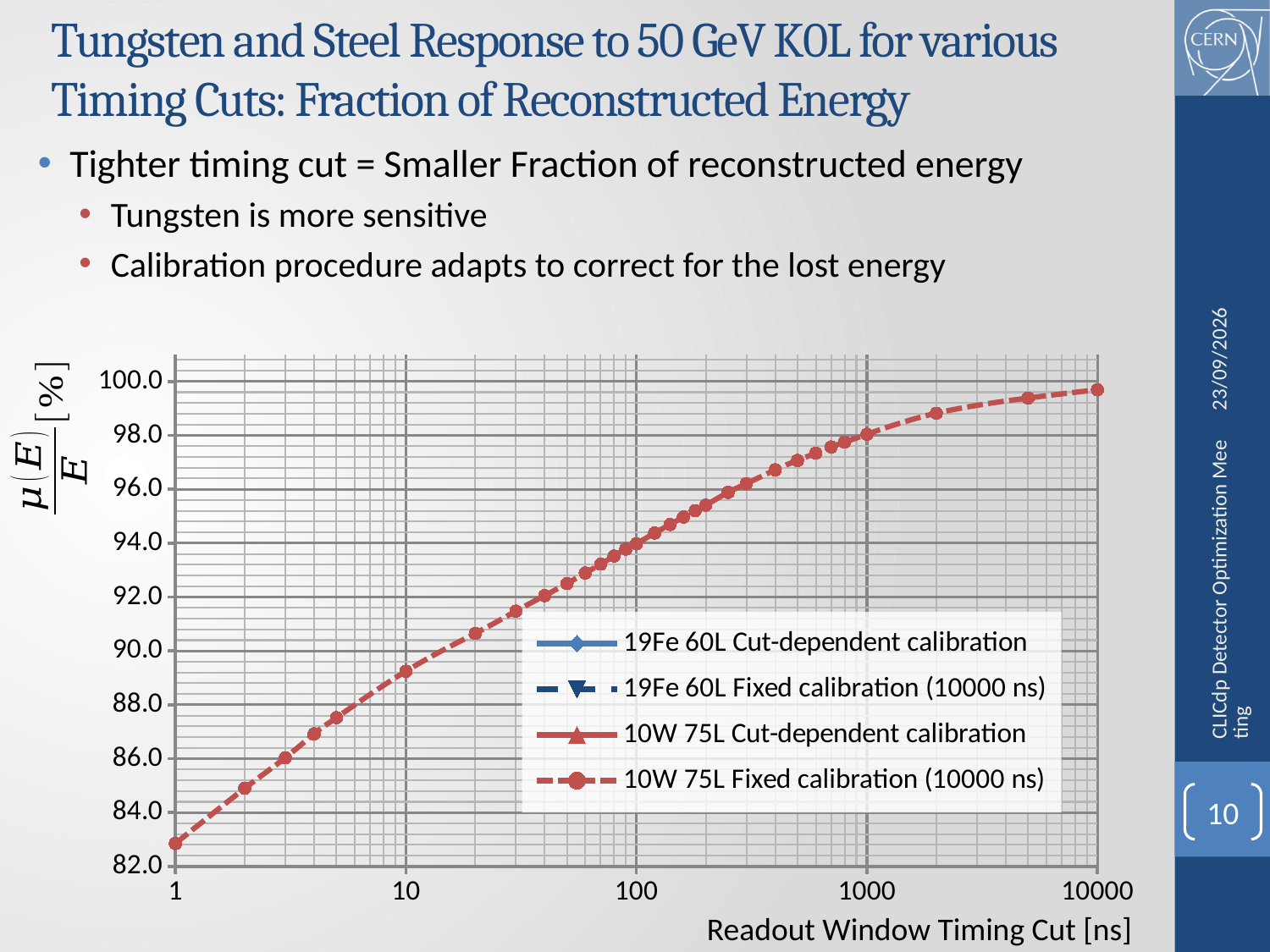
Which is larger, the plotted value at 1 ns or the plotted value at 10000 ns? 10000 ns Is the plotted value at a readout window timing cut of 10 ns greater or less than 90.0? less What is the label of the x axis of the chart? Readout Window Timing Cut [ns] Is the plotted value at a readout window timing cut of 1 ns greater or less than 84.0? less Does the plotted value rise or fall as the readout window timing cut increases along the x axis? rise How many series does the chart legend list? 4 Is the plotted value at a readout window timing cut of 1 ns greater or less than 82.0? greater What is the last entry listed in the chart legend? 10W 75L Fixed calibration (10000 ns) What kind of chart is shown on the slide? line chart